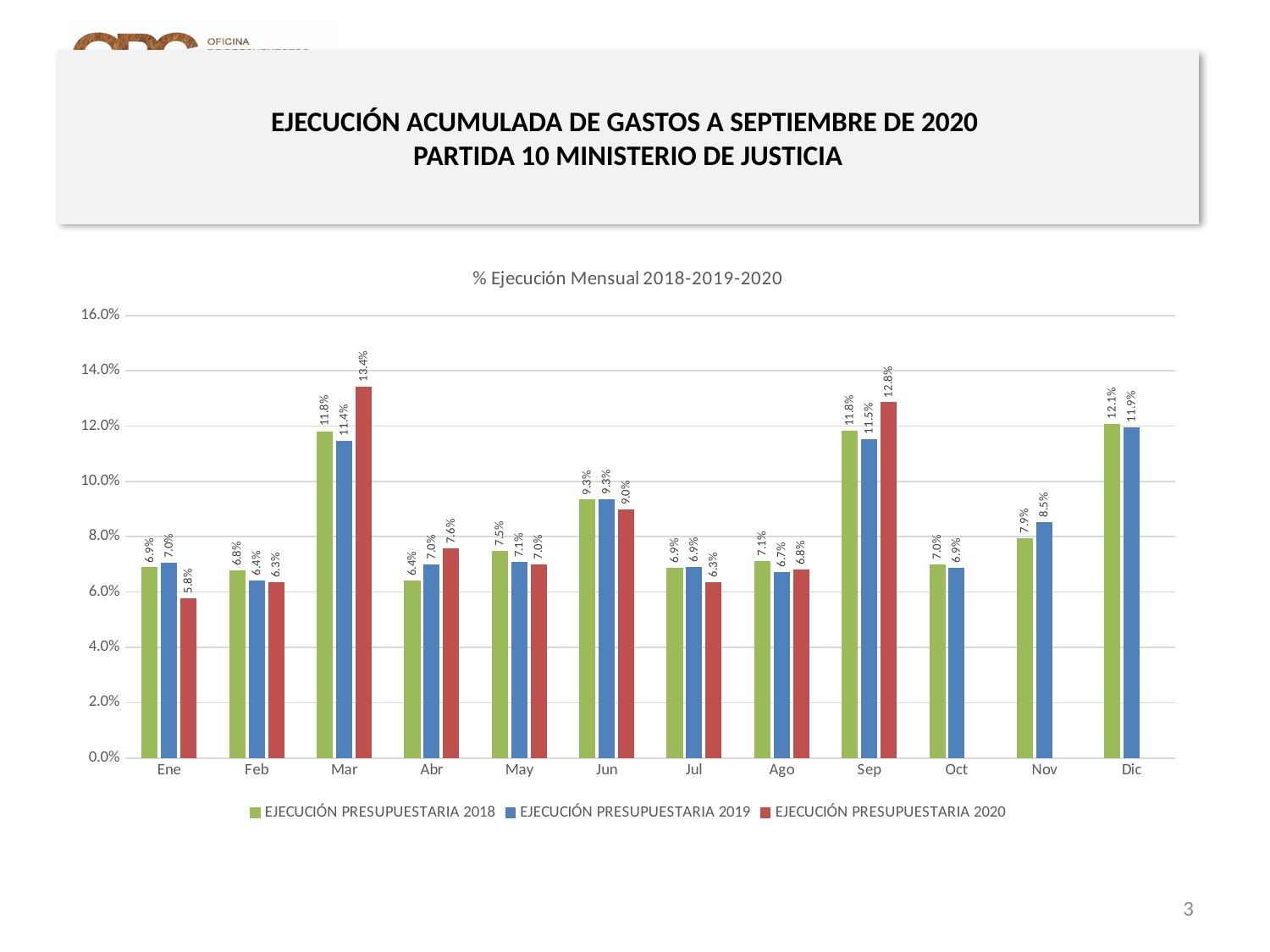
Which month has the lowest value for EJECUCIÓN PRESUPUESTARIA 2020? Ene What is the difference between EJECUCIÓN PRESUPUESTARIA 2020 and EJECUCIÓN PRESUPUESTARIA 2018 in Sep? 1.0% What is the title of the chart? % Ejecución Mensual 2018-2019-2020 How many months are shown on the x axis? 12 What is the value for EJECUCIÓN PRESUPUESTARIA 2019 in Nov? 8.5% What is the value for EJECUCIÓN PRESUPUESTARIA 2018 in Sep? 11.8% How many series does the legend list? 3 Is the value for EJECUCIÓN PRESUPUESTARIA 2018 in Dic greater or less than 10.0%? greater What kind of chart is shown on the slide? Bar chart Which is larger in Abr: EJECUCIÓN PRESUPUESTARIA 2018 or EJECUCIÓN PRESUPUESTARIA 2020? EJECUCIÓN PRESUPUESTARIA 2020 What is the value for EJECUCIÓN PRESUPUESTARIA 2020 in Mar? 13.4% Which month has the highest value for EJECUCIÓN PRESUPUESTARIA 2020? Mar